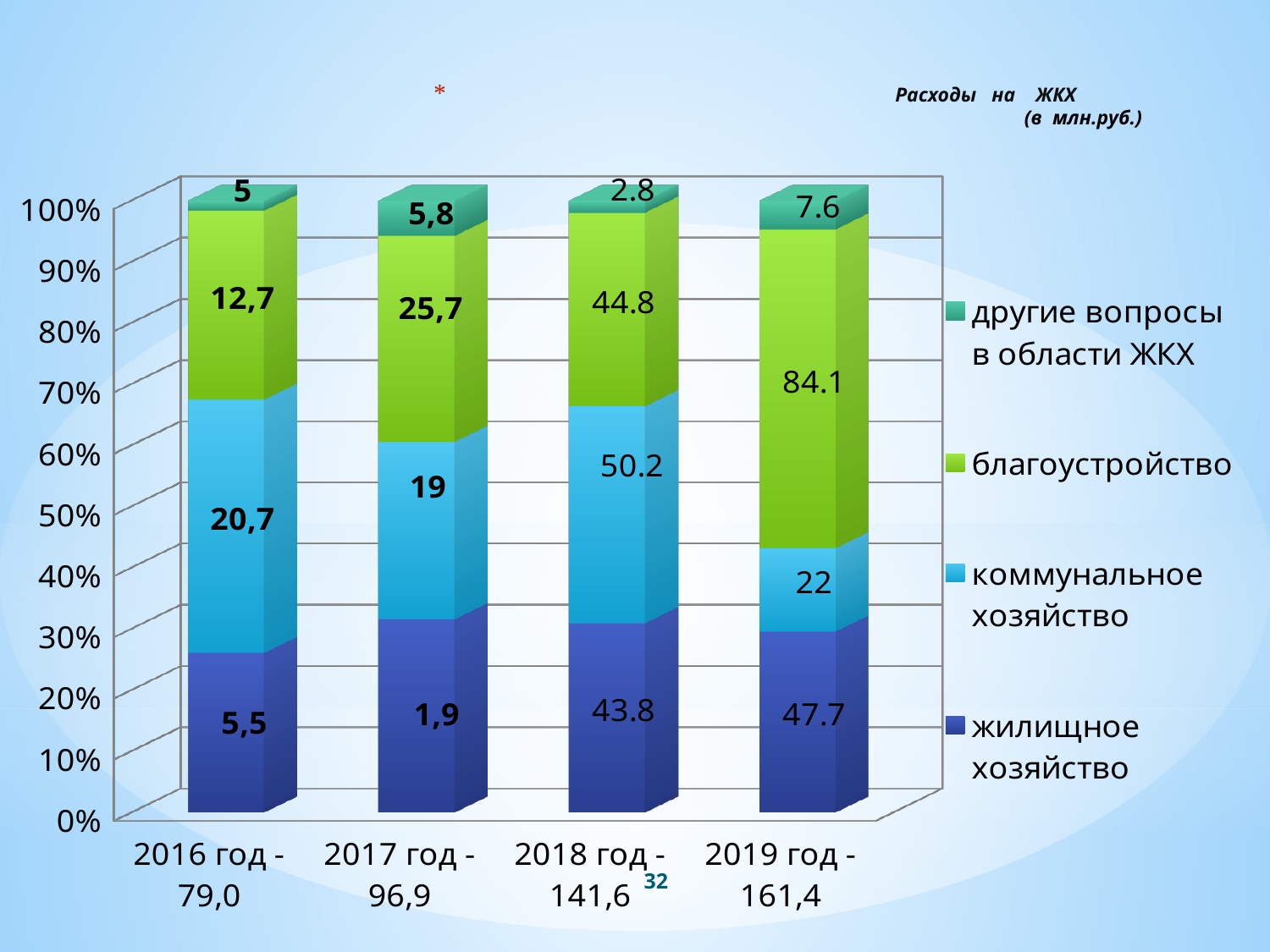
What is the value for другие вопросы в области ЖКХ in 2016 год? 5 What is the value for коммунальное хозяйство in 2018 год? 50.2 In which year is the value for жилищное хозяйство the lowest? 2017 год How many series does the legend list? 4 What is the title of the chart? Расходы на ЖКХ (в млн.руб.) How many year categories are shown on the x axis? 4 What is the value for жилищное хозяйство in 2017 год? 1,9 In which year is the value for благоустройство the highest? 2019 год Which is larger: the value for другие вопросы в области ЖКХ in 2017 год or in 2018 год? 2017 год What is the value for благоустройство in 2019 год? 84.1 What type of chart is shown on the slide? stacked bar chart What is the difference between the коммунальное хозяйство values for 2018 год and 2019 год? 28.2